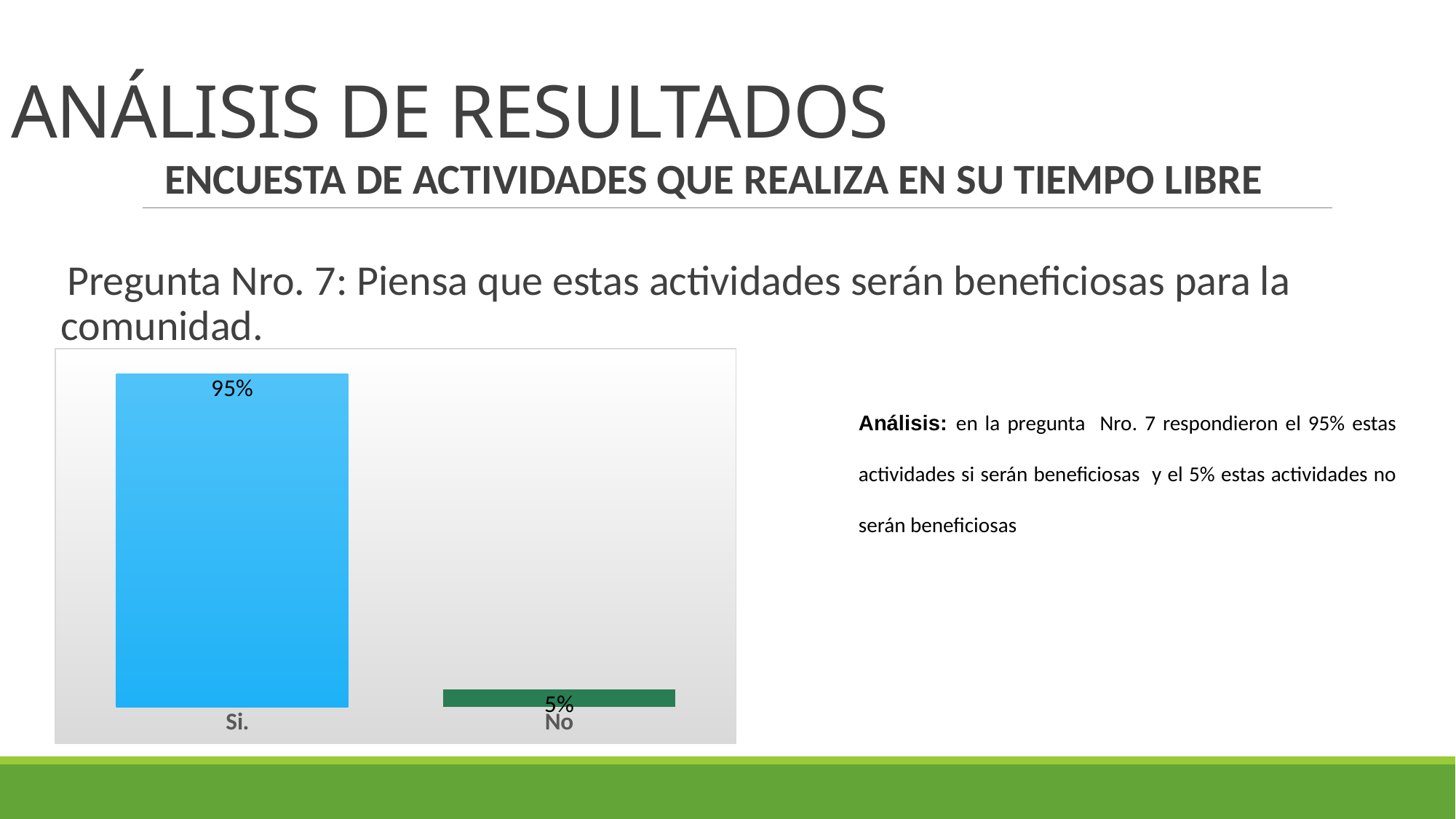
Which category has the highest value? Si. What colour is the bar for the "Si." category? Blue How many categories are shown in the chart? 2 Which category has the lowest value? No Which is larger, the value for "Si." or the value for "No"? Si. What kind of chart is shown on the slide? Bar chart What is the difference between the values for "Si." and "No"? 90% What is the value for the "Si." category? 95% What colour is the bar for the "No" category? Green What is the value for the "No" category? 5% What is the total of the two values shown in the chart? 100%